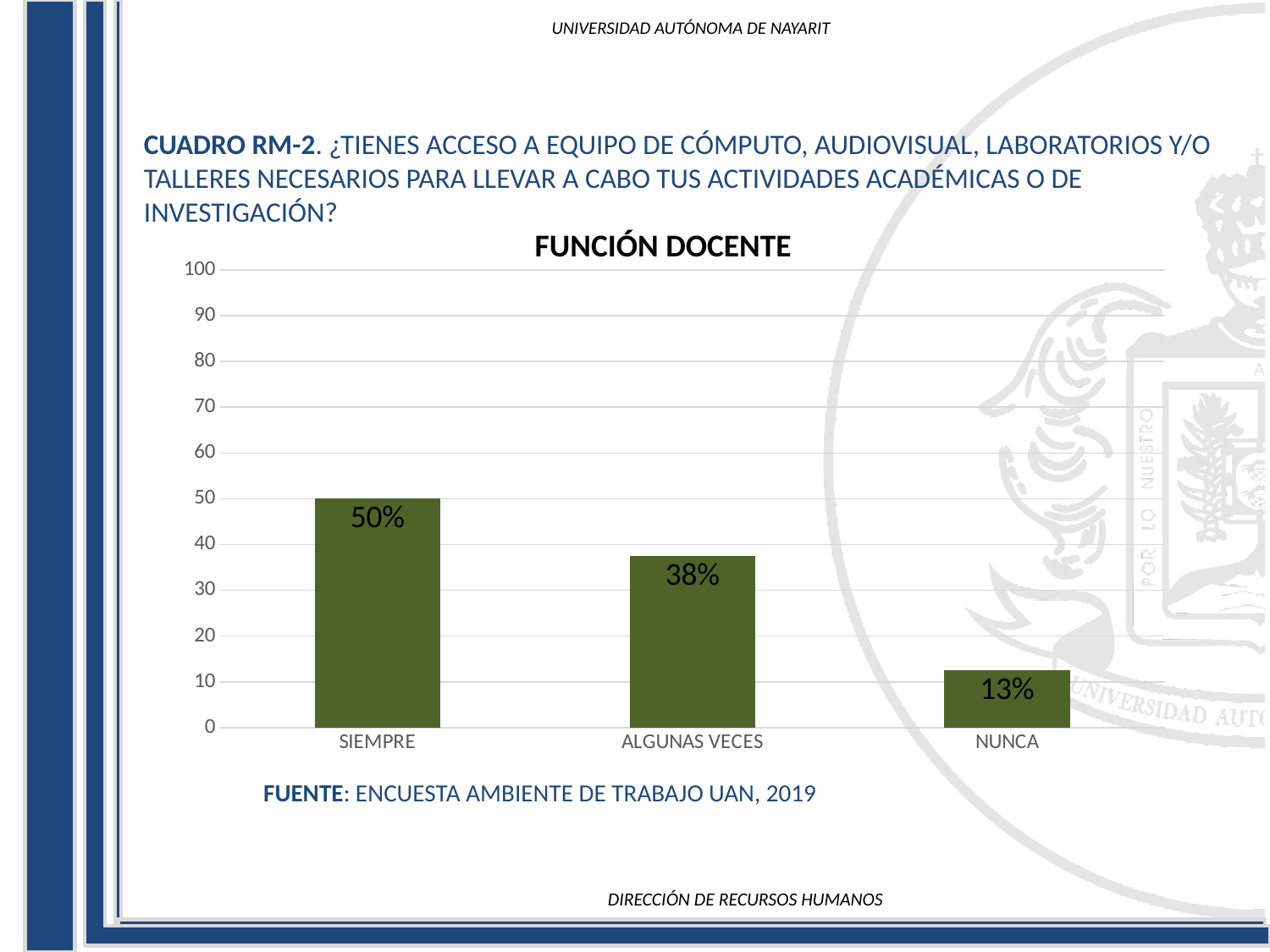
How many categories are shown on the x axis? 3 Which is larger, the value for ALGUNAS VECES or the value for NUNCA? ALGUNAS VECES What kind of chart is shown on the slide? bar chart Which category has the highest value? SIEMPRE Which category has the lowest value? NUNCA Is the value for ALGUNAS VECES greater or less than 40? less What is the value for NUNCA? 13% What is the value for SIEMPRE? 50% What is the value for ALGUNAS VECES? 38% What is the title of the chart? FUNCIÓN DOCENTE What is the difference between the values for ALGUNAS VECES and NUNCA? 25% What is the difference between the values for SIEMPRE and ALGUNAS VECES? 12%